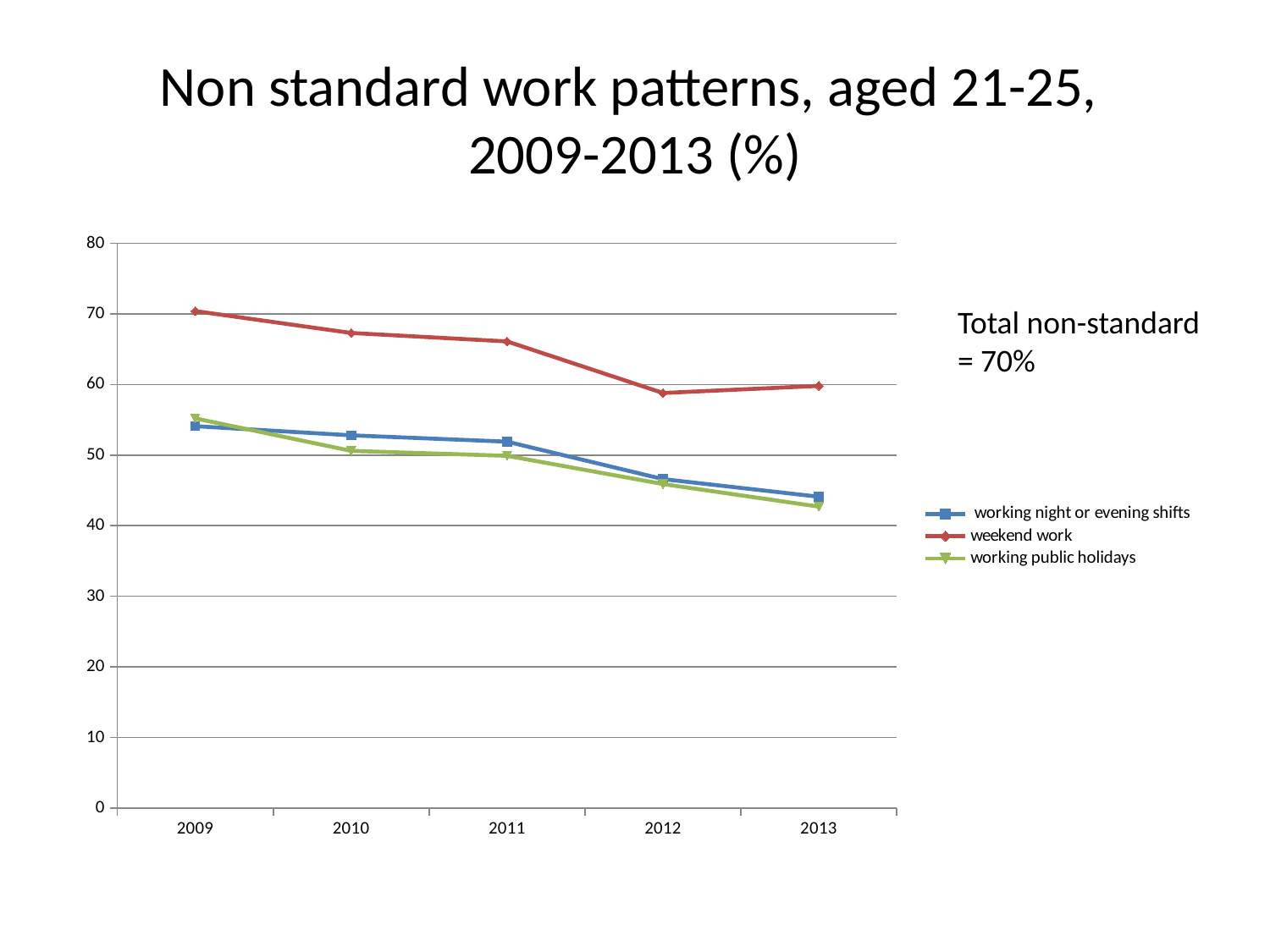
Is the value for weekend work in 2012 greater or less than 60? less Is the value for working public holidays in 2013 greater or less than 50? less In which year is the value for weekend work highest? 2009 How many series does the legend list? 3 Is the value for working night or evening shifts in 2009 greater or less than 50? greater Which series has the highest values across all years? weekend work In 2010, which is larger: working night or evening shifts or working public holidays? working night or evening shifts What kind of chart is shown on the slide? line chart In which year is the value for working night or evening shifts lowest? 2013 Do the values for working night or evening shifts rise or fall from 2009 to 2013? fall How many years are plotted along the x axis? 5 What is the title of the chart? Non standard work patterns, aged 21-25, 2009-2013 (%)